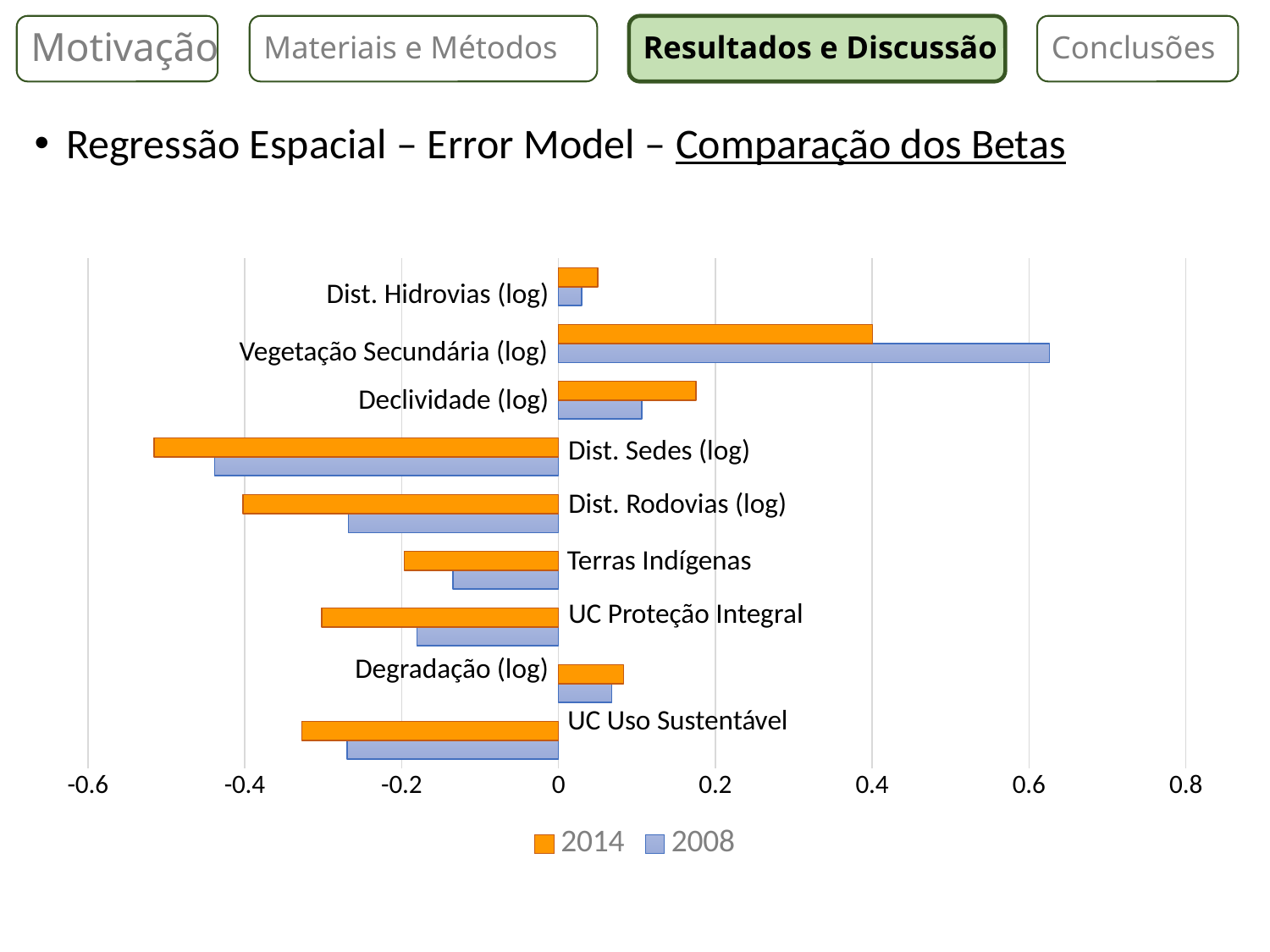
Is the 2008 value for Vegetação Secundária (log) greater or less than 0.6? greater Which category has the lowest value for the 2014 series? Dist. Sedes (log) Which category has the highest value for the 2008 series? Vegetação Secundária (log) Which category has the lowest value for the 2008 series? Dist. Sedes (log) How many categories are plotted on the chart? 9 How many series does the legend list? 2 Which colour represents the 2014 series in the chart? orange Is the 2008 value for Dist. Rodovias (log) greater or less than -0.4? greater For Declividade (log), which series has the larger value, 2014 or 2008? 2014 For Vegetação Secundária (log), which series has the larger value, 2014 or 2008? 2008 Is the 2014 value for Dist. Sedes (log) greater or less than -0.4? less What kind of chart is shown on the slide? bar chart